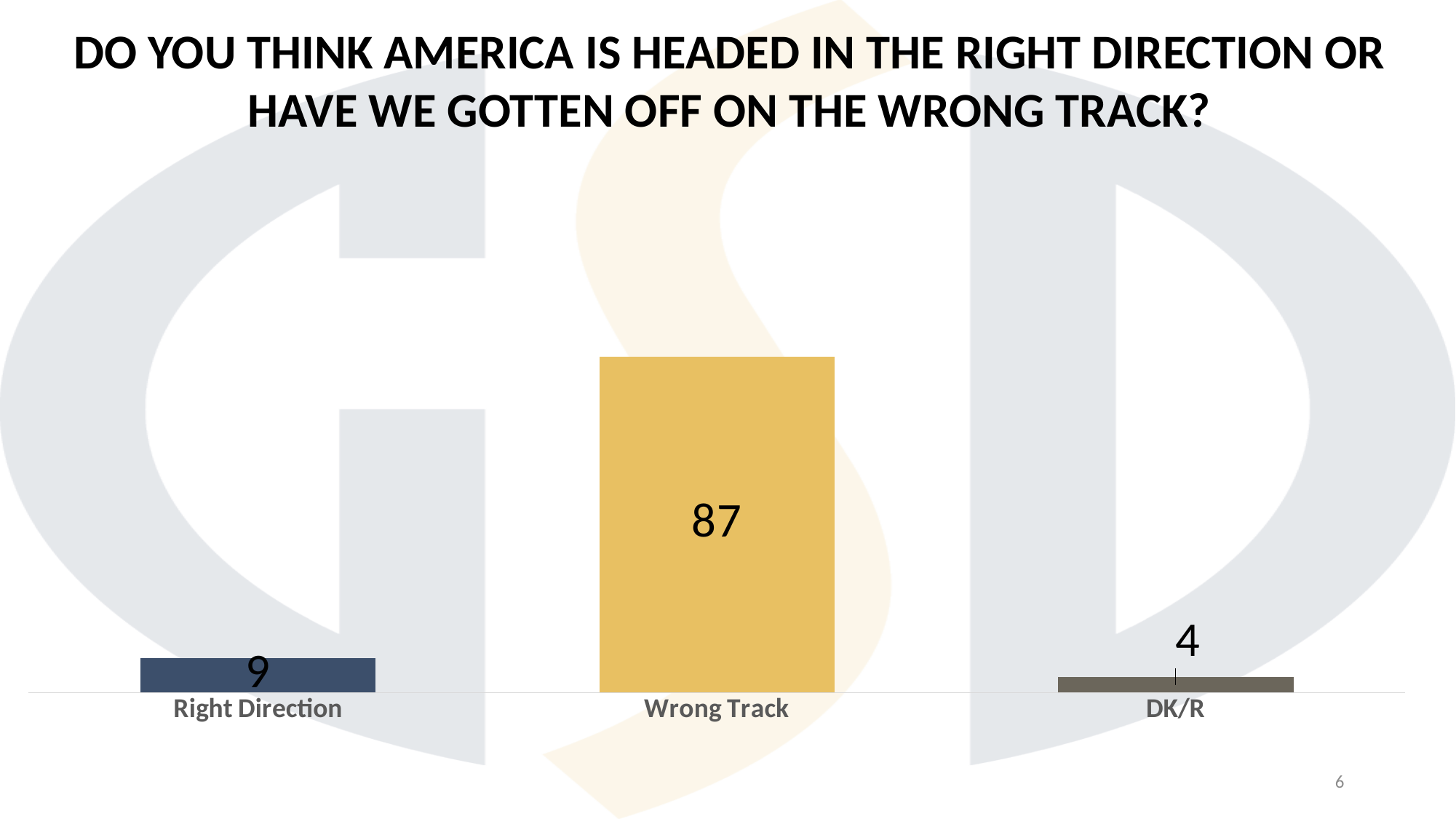
How many categories are shown in the chart? 3 Which is larger, the value for Right Direction or the value for DK/R? Right Direction Which category has the highest value? Wrong Track What is the difference between the values for Wrong Track and Right Direction? 78 What is the value for DK/R? 4 What is the value for Wrong Track? 87 What is the value for Right Direction? 9 What is the total of the three values shown in the chart? 100 What colour is the Wrong Track bar? yellow Which category has the lowest value? DK/R What kind of chart is shown on the slide? bar chart What is the difference between the values for Right Direction and DK/R? 5